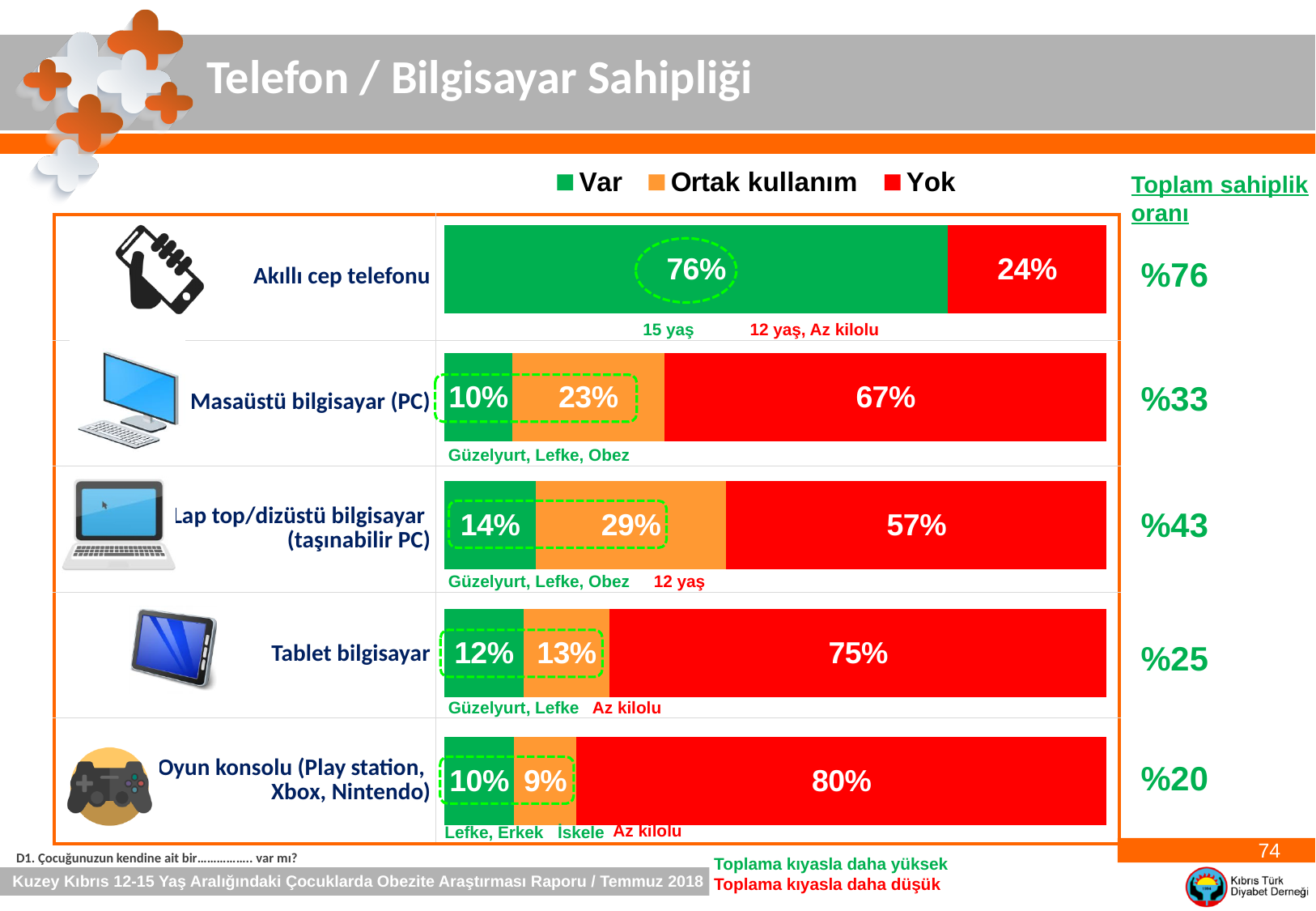
What is the 'Yok' value for Oyun konsolu (Play station, Xbox, Nintendo)? 80% What is the 'Toplam sahiplik oranı' shown for Lap top/dizüstü bilgisayar (taşınabilir PC)? %43 What is the 'Var' value for Akıllı cep telefonu? 76% What is the difference between the 'Yok' values for Tablet bilgisayar and Lap top/dizüstü bilgisayar (taşınabilir PC)? 18% Which category has the highest 'Yok' value? Oyun konsolu (Play station, Xbox, Nintendo) How many series does the legend list? 3 Which is larger: the 'Ortak kullanım' value for Masaüstü bilgisayar (PC) or for Tablet bilgisayar? Masaüstü bilgisayar (PC) What is the 'Yok' value for Masaüstü bilgisayar (PC)? 67% How many categories (device types) are plotted in the chart? 5 Which category has the lowest 'Yok' value? Akıllı cep telefonu What is the 'Ortak kullanım' value for Lap top/dizüstü bilgisayar (taşınabilir PC)? 29% What kind of chart is shown on the slide? Stacked bar chart